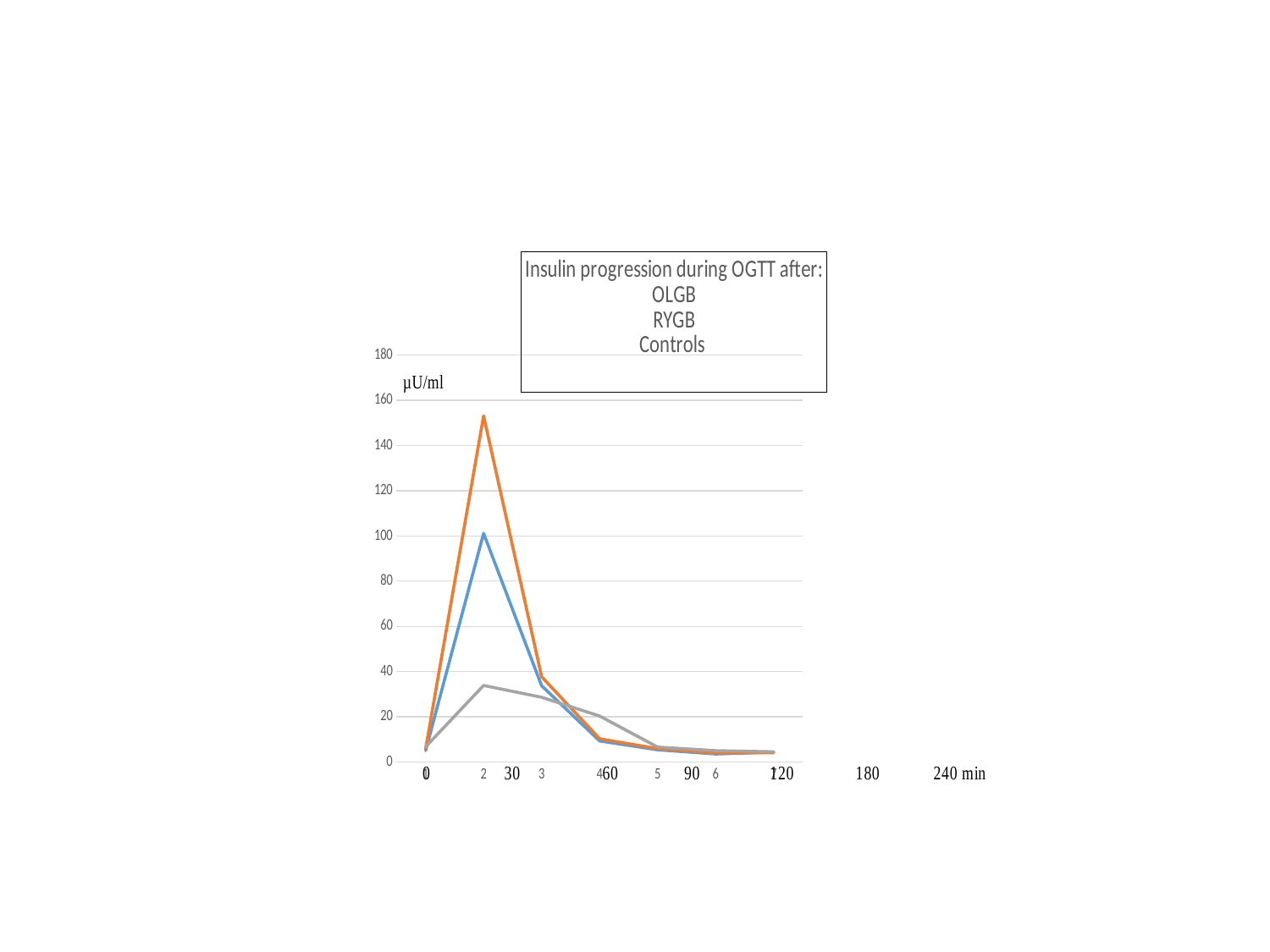
Is the peak value of the orange line greater or less than 160? less At the second x-axis point, which line is higher, the blue line or the gray line? the blue line What kind of chart is shown on the slide? line chart What is the highest tick value shown on the y axis? 180 Is the peak value of the gray line greater or less than 40? less What unit is shown on the y axis of the chart? µU/ml Is the peak value of the blue line greater or less than 80? greater Which line reaches the highest peak value? the orange line How many lines are plotted on the chart? 3 Which line has the lowest peak value? the gray line After reaching their peak at the second x-axis point, do the orange and blue lines rise or fall toward the right end of the x axis? fall